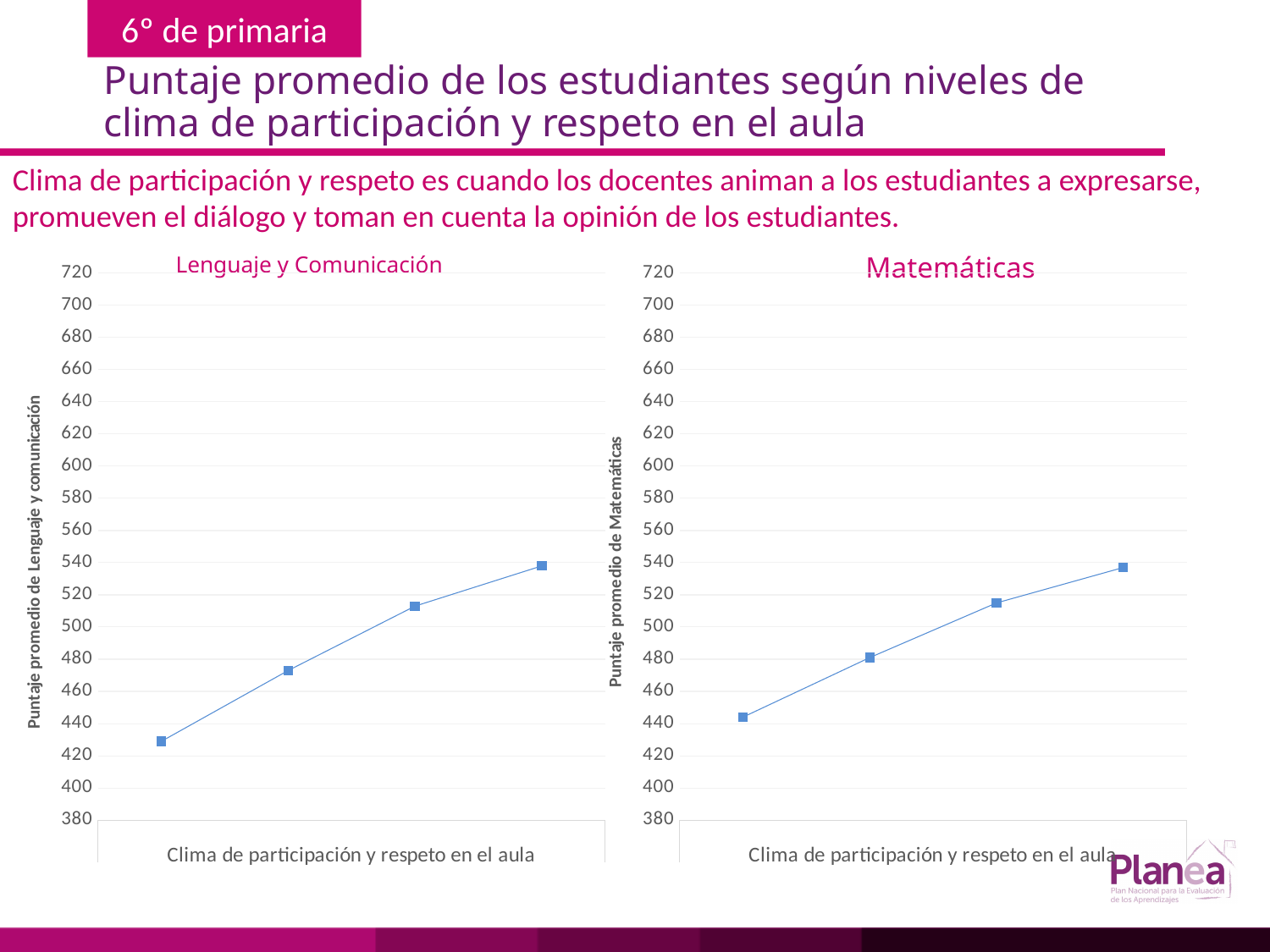
On the 'Matemáticas' chart, do the values rise or fall from left to right? rise On the 'Lenguaje y Comunicación' chart, is the value of the last (rightmost) point greater or less than 520? greater On the 'Lenguaje y Comunicación' chart, do the values rise or fall from left to right? rise What is the y-axis label on the 'Lenguaje y Comunicación' chart? Puntaje promedio de Lenguaje y comunicación How many data points are plotted on the 'Matemáticas' chart? 4 What is the x-axis label on the 'Matemáticas' chart? Clima de participación y respeto en el aula What kind of chart is the 'Matemáticas' chart? line chart On the 'Matemáticas' chart, is the value of the first (leftmost) point greater or less than 460? less What kind of chart is the 'Lenguaje y Comunicación' chart? line chart How many data points are plotted on the 'Lenguaje y Comunicación' chart? 4 On the 'Matemáticas' chart, is the value of the last (rightmost) point greater or less than 520? greater